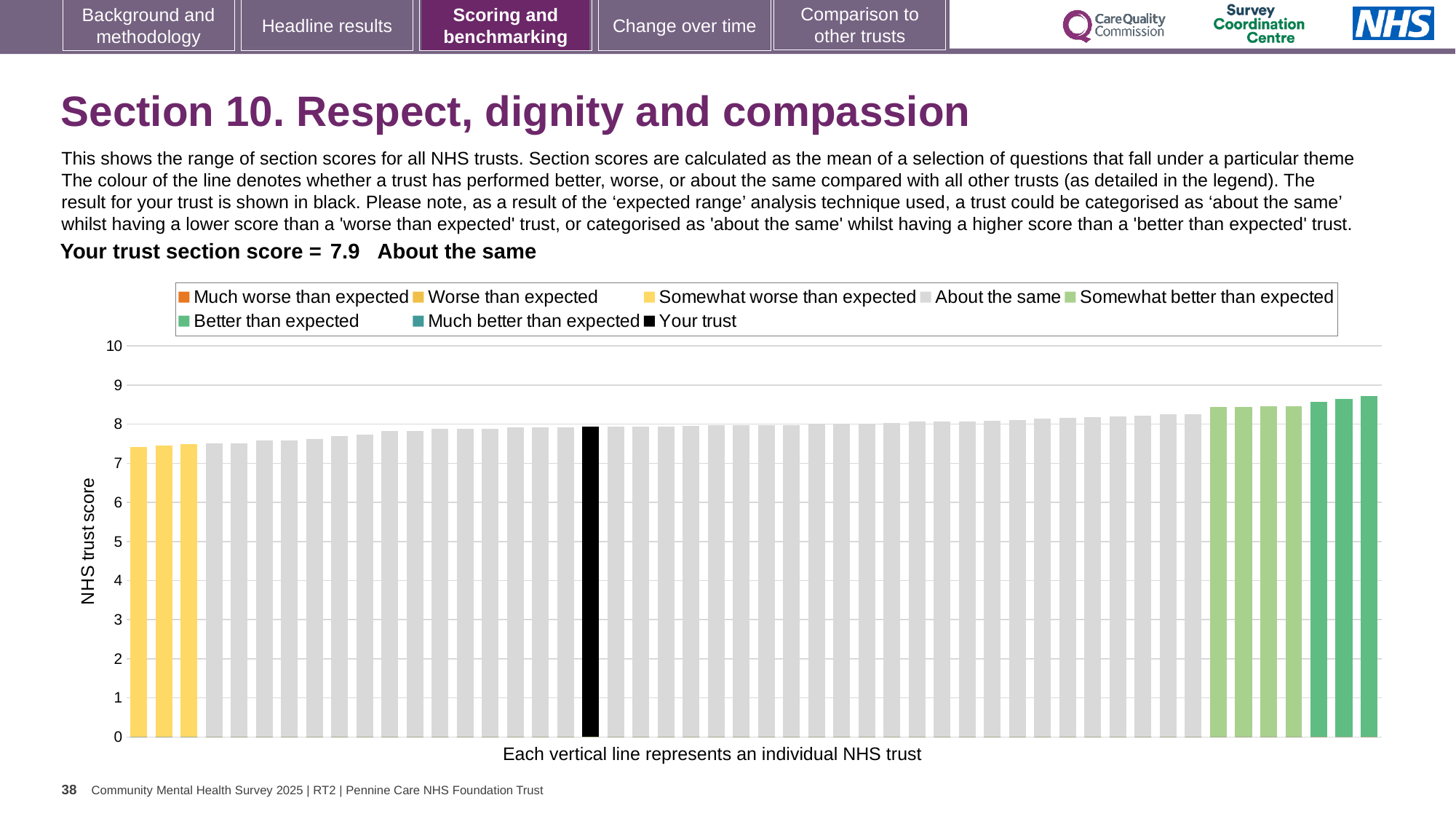
Is the value of the shortest bar greater or less than 8? less Is the value for your trust greater or less than 5? greater Do the bar values rise or fall from left to right along the x axis? rise What is the label on the y axis of the chart? NHS trust score How many entries does the chart legend list? 8 What colour is the bar representing your trust? black What kind of chart is shown on the slide? bar chart How many trusts are shown as 'Somewhat worse than expected' (yellow bars)? 3 Is the value of the tallest bar greater or less than 8? greater How many trusts are shown as 'Better than expected' (dark green bars)? 3 What is the section score for your trust shown on the slide? 7.9 How is your trust's section score categorised compared with other trusts? About the same